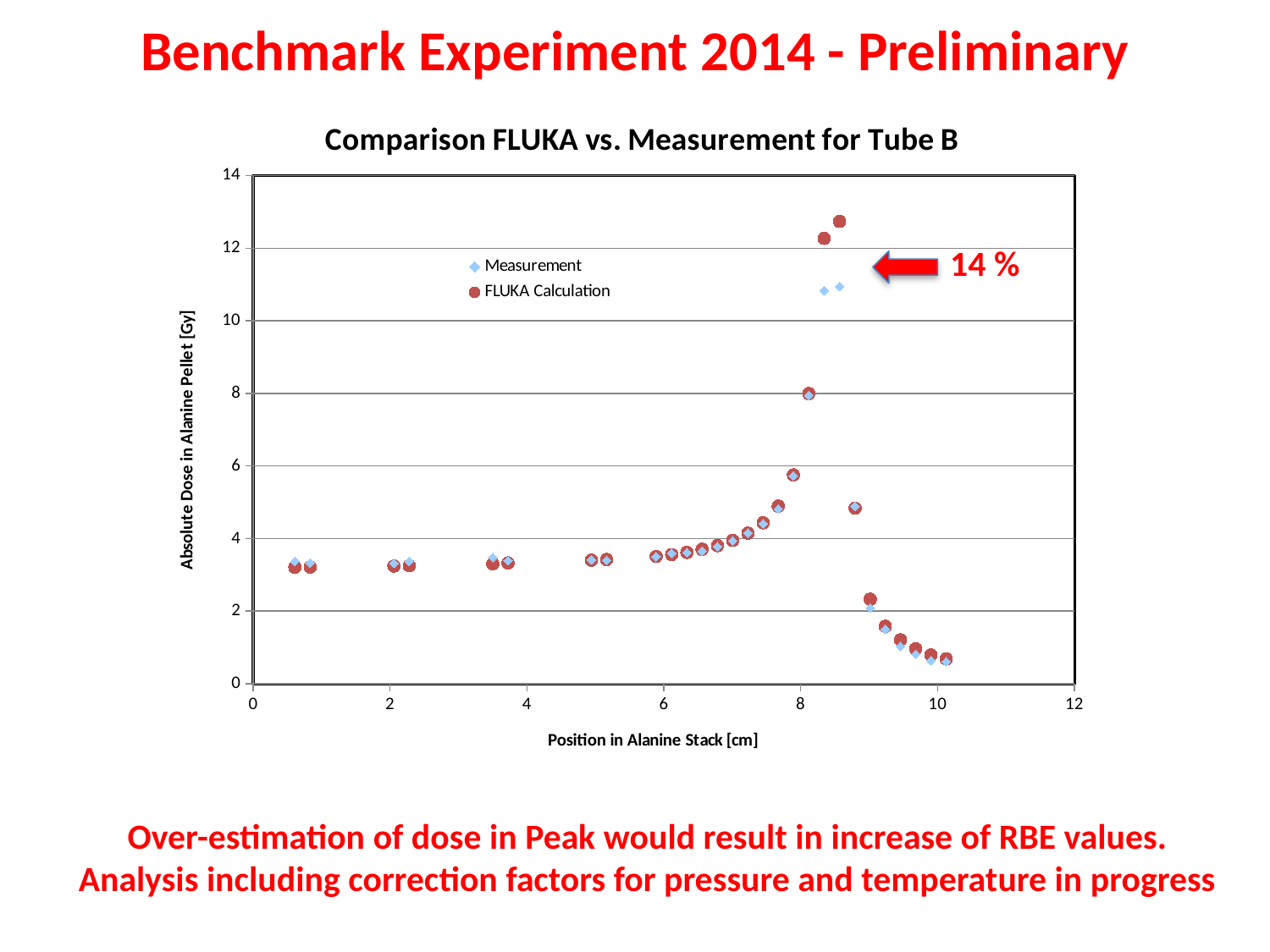
Which series reaches the highest dose value on the chart? FLUKA Calculation After the peak, from about 9 cm to 10 cm, do the dose values rise or fall? fall What kind of chart is shown on the slide? Scatter chart At the peak near 8.5 cm, which series shows the larger dose, Measurement or FLUKA Calculation? FLUKA Calculation What is the title of the chart? Comparison FLUKA vs. Measurement for Tube B Between positions 6 cm and 8 cm, do the dose values rise or fall along the x axis? rise Is the dose at the last position, around 10 cm, greater or less than 2 Gy? less How many series does the chart legend list? 2 Is the highest Measurement value greater or less than 10 Gy? greater What are the two series named in the chart legend? Measurement and FLUKA Calculation Are the dose values at positions below 4 cm greater or less than 4 Gy? less